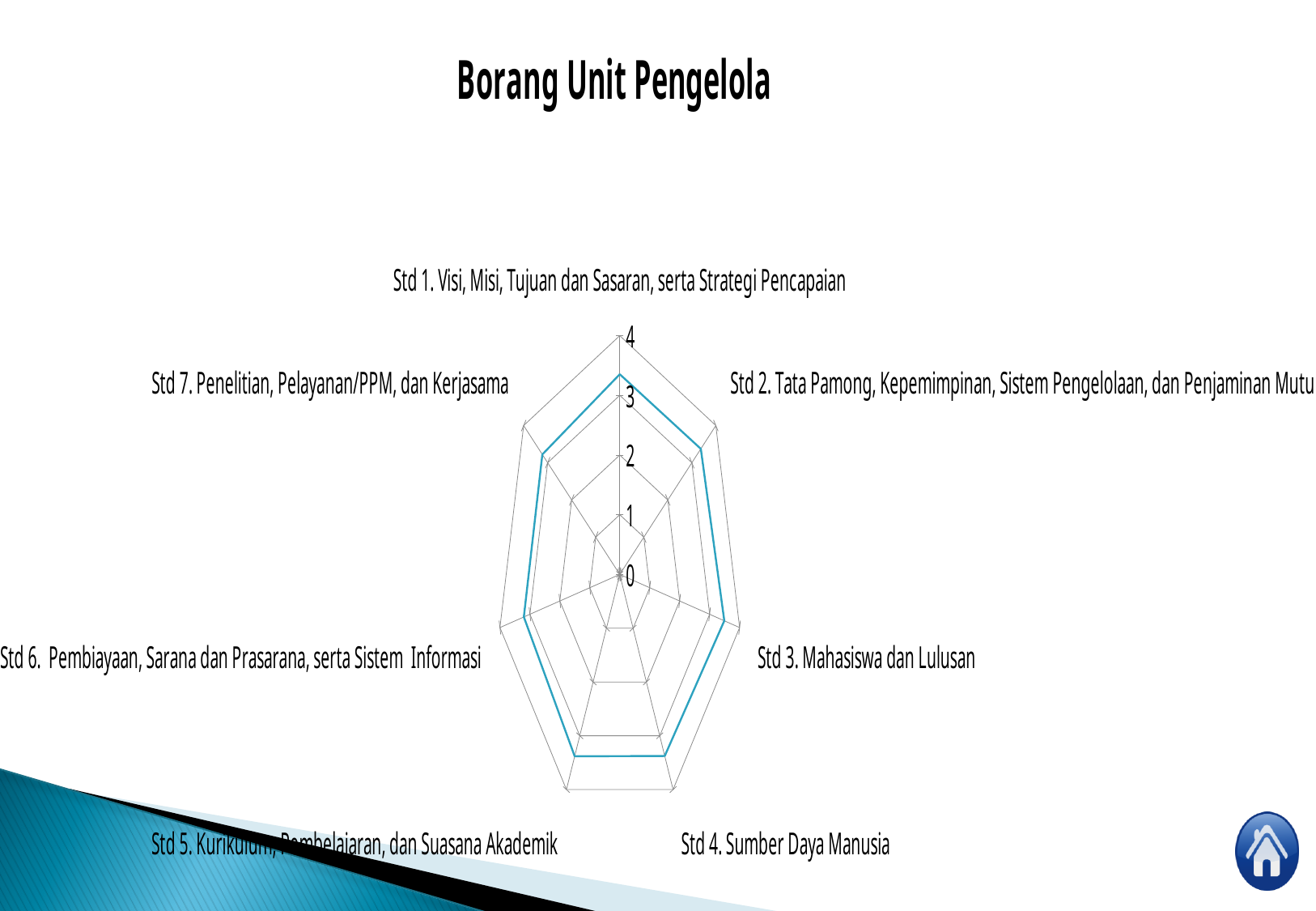
Is the value for Std 6. Pembiayaan, Sarana dan Prasarana, serta Sistem Informasi greater or less than 2? greater Is the value for Std 4. Sumber Daya Manusia greater or less than 3? greater Is the value for Std 5. Kurikulum, Pembelajaran, dan Suasana Akademik greater or less than 1? greater How many categories (standards) are plotted on the radar chart? 7 What kind of chart is shown on the slide? Radar chart What is the highest value shown on the chart's axis scale? 4 What is the title of the chart on the slide? Borang Unit Pengelola